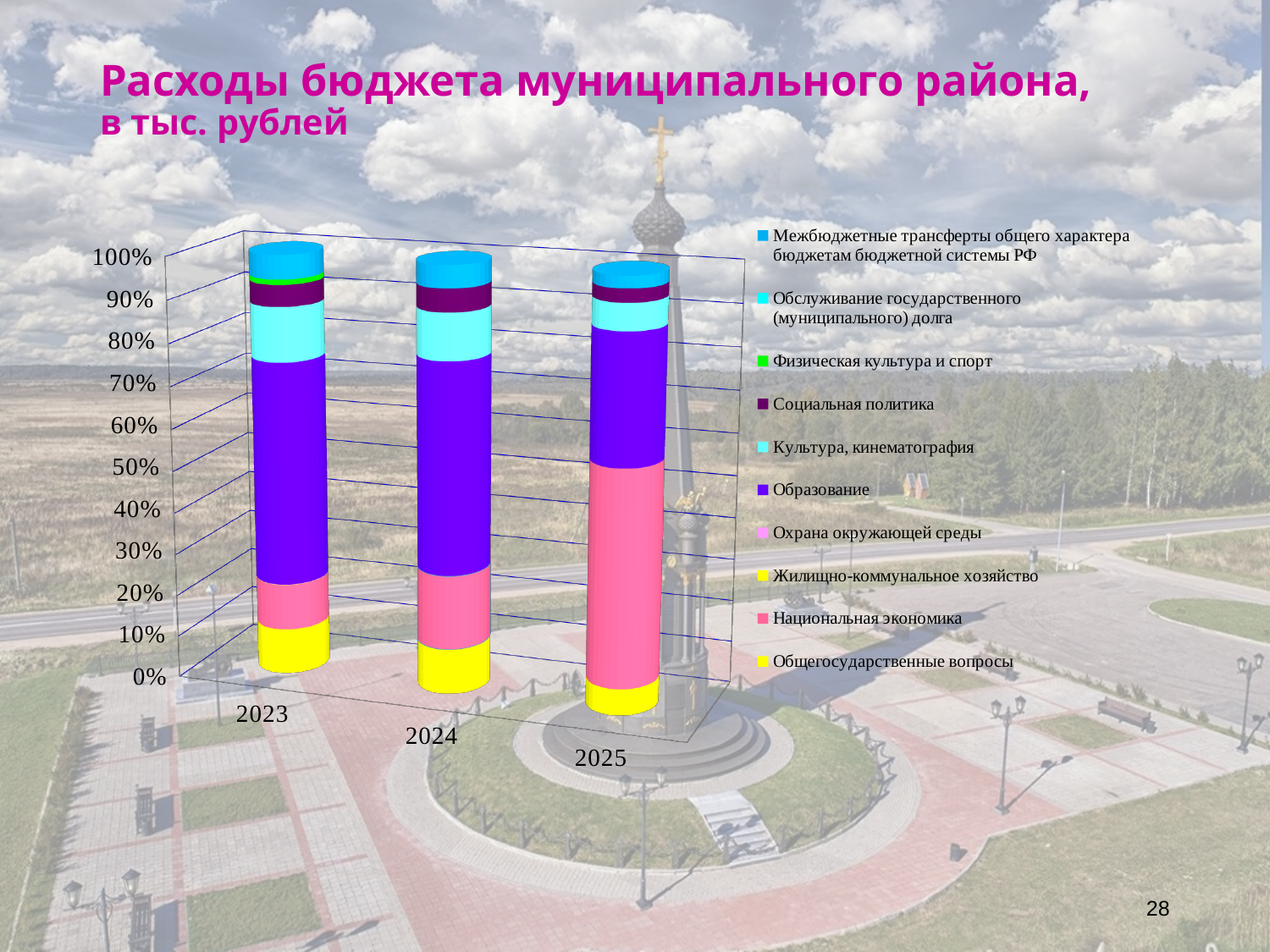
What is the title of the chart on the slide? Расходы бюджета муниципального района, в тыс. рублей Does the share of Национальная экономика rise or fall from 2023 to 2025? rise Does the share of Образование rise or fall from 2023 to 2025? fall Is the share of Общегосударственные вопросы in the 2023 bar greater or less than 20%? less Is the share of Национальная экономика in the 2025 bar greater or less than 30%? greater In the 2023 bar, which segment is larger: Образование or Национальная экономика? Образование What kind of chart is shown on the slide? Stacked bar chart Which legend entry is listed first (at the top) in the chart legend? Межбюджетные трансферты общего характера бюджетам бюджетной системы РФ How many years (categories) are shown on the x axis of the chart? 3 Is the share of Образование in the 2023 bar greater or less than 40%? greater How many series does the chart legend list? 10